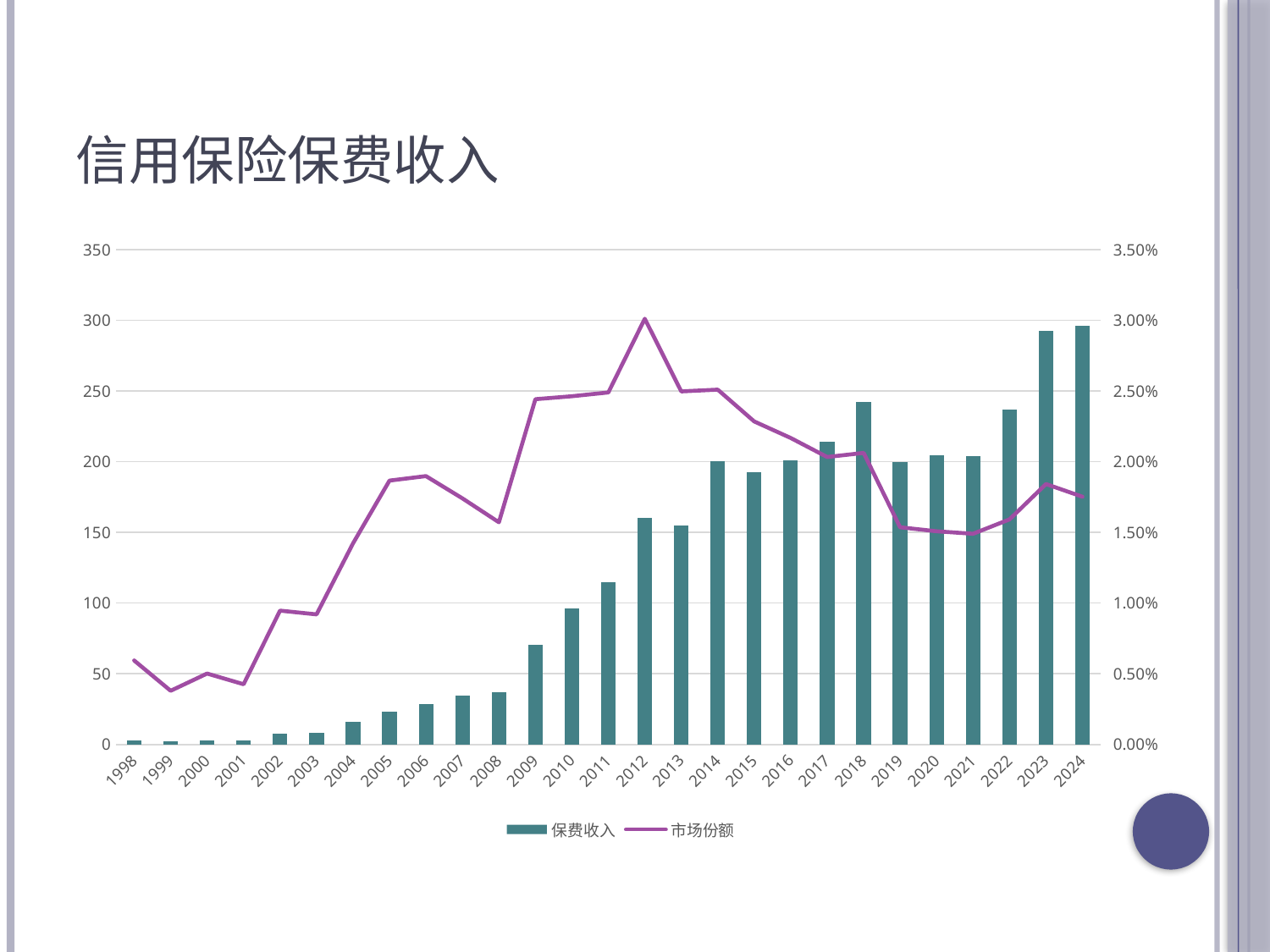
Does the 保费收入 series generally rise or fall from 1998 to 2024? rise Which year has the larger 保费收入 bar, 2017 or 2018? 2018 What is the title of the chart? 信用保险保费收入 Is the 保费收入 bar for 2018 greater or less than 200? greater In which year does the 市场份额 line reach its highest point? 2012 Is the 市场份额 value for 2005 greater or less than 2.00%? less How many series does the legend list? 2 How many years are shown on the x axis? 27 Is the 保费收入 bar for 2011 greater or less than 100? greater What kind of chart is shown on the slide? A combined bar and line chart In which year is the 市场份额 line at its lowest point? 1999